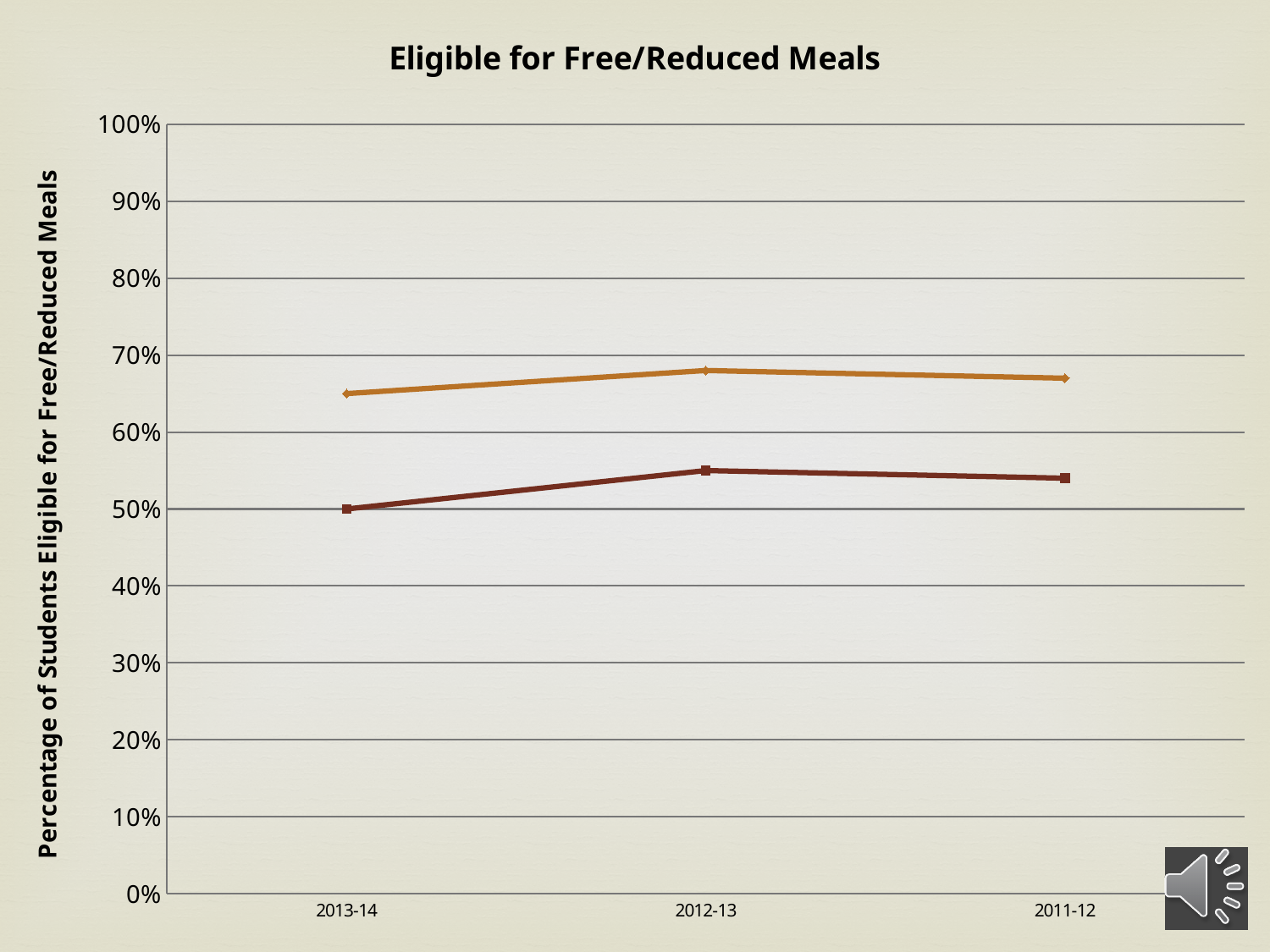
What is the value of the dark red line for 2013-14? 50% Is the value of the dark red line for 2012-13 greater or less than 60%? less How many lines are plotted on the chart? 2 What is the label on the vertical axis of the chart? Percentage of Students Eligible for Free/Reduced Meals How many school years are shown along the x axis? 3 What kind of chart is shown on the slide? line chart For the orange line, which school year has the highest value? 2012-13 For the dark red line, which school year has the lowest value? 2013-14 What is the title of the chart? Eligible for Free/Reduced Meals Which line has the higher value for 2011-12, the orange line or the dark red line? orange line Is the value of the orange line for 2013-14 greater or less than 70%? less Is the value of the orange line for 2012-13 greater or less than 60%? greater